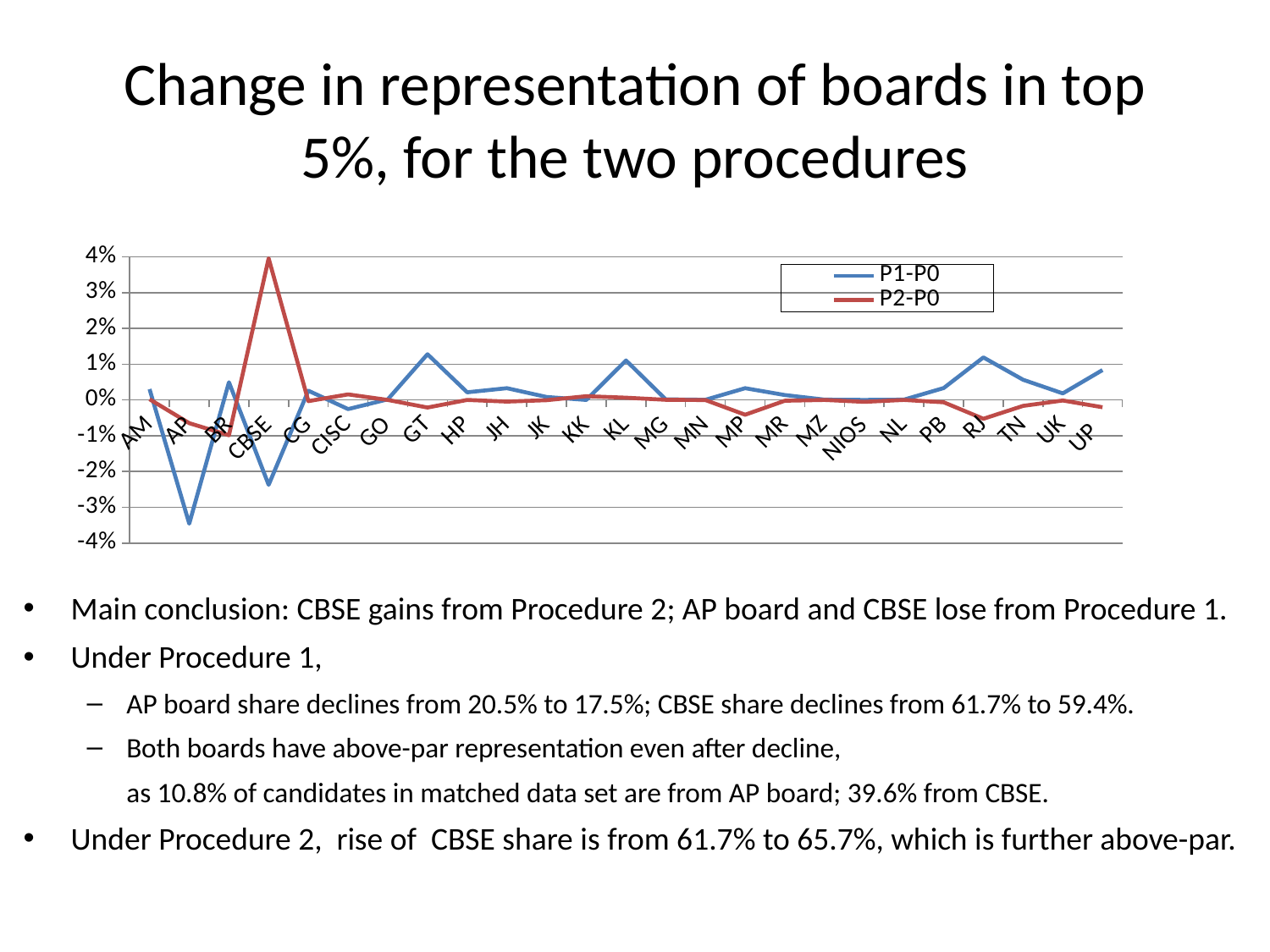
How many series does the chart legend list? 2 Is the P1-P0 value for CBSE greater or less than -2%? less At CBSE, which series has the higher value, P1-P0 or P2-P0? P2-P0 Is the P1-P0 value for AP greater or less than -3%? less What kind of chart is shown on the slide? line chart For which board does the P1-P0 series reach its lowest value? AP What are the two series named in the legend? P1-P0 and P2-P0 Is the P1-P0 value for GT greater or less than 1%? greater For which board does the P2-P0 series reach its highest value? CBSE What is the title of the chart's slide? Change in representation of boards in top 5%, for the two procedures How many boards (categories) are plotted along the x axis? 25